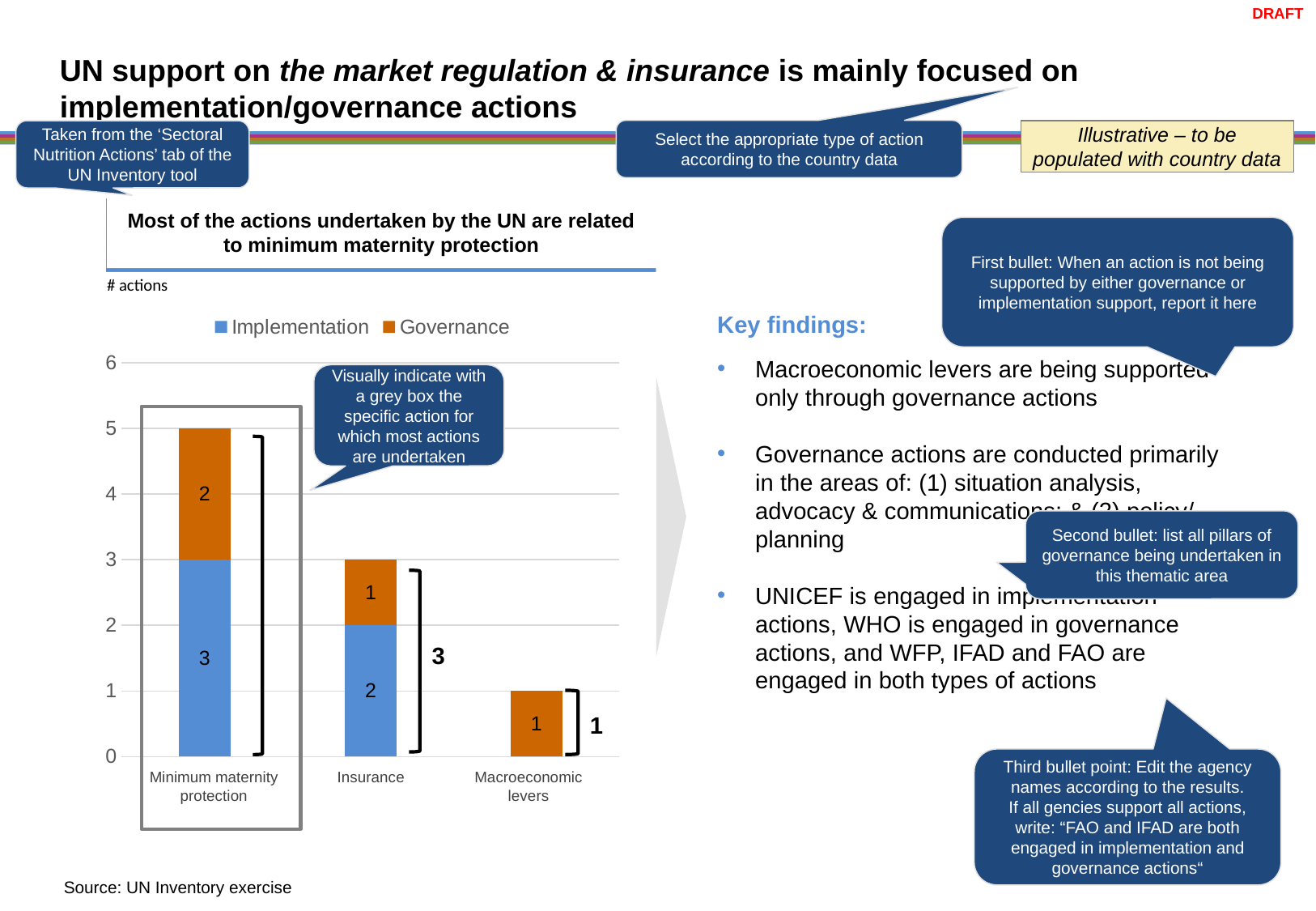
What is the total number of actions for Minimum maternity protection? 5 How many series does the chart legend list? 2 What is the Implementation value for Insurance? 2 What is the Implementation value for Minimum maternity protection? 3 What is the Governance value for Minimum maternity protection? 2 Which category has the lowest total number of actions? Macroeconomic levers Which category has the highest total number of actions? Minimum maternity protection What kind of chart is shown on the slide? stacked bar chart What is the total number of actions for Insurance? 3 What is the Governance value for Macroeconomic levers? 1 How many categories are shown on the x axis of the chart? 3 What is the difference between the Implementation values for Minimum maternity protection and Insurance? 1